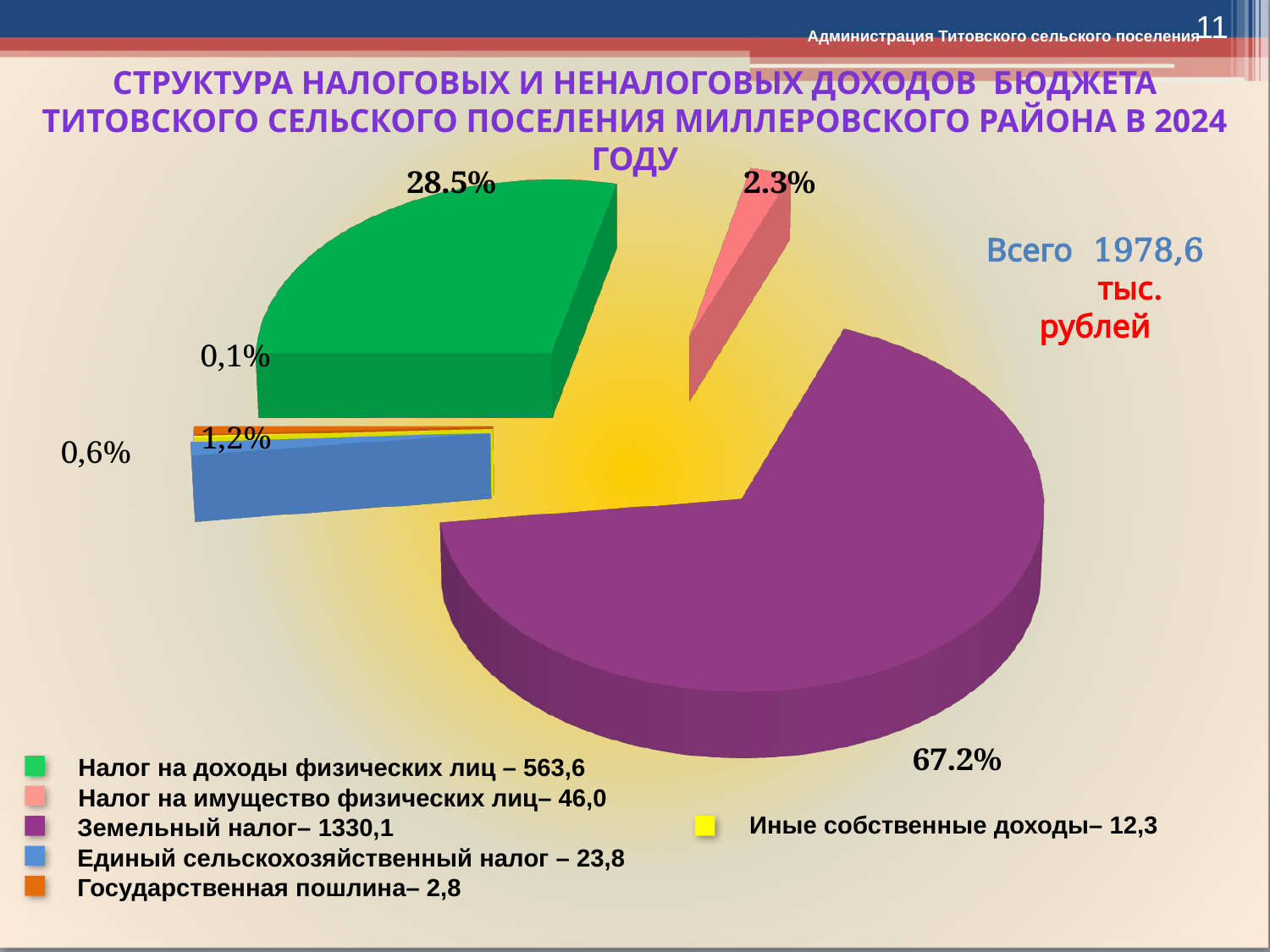
How many categories does the legend list? 6 What share of the pie does Налог на доходы физических лиц hold? 28.5% Which is larger: the slice for Налог на доходы физических лиц or the slice for Налог на имущество физических лиц? Налог на доходы физических лиц What share of the pie does Земельный налог hold? 67.2% Which category has the largest slice of the pie? Земельный налог What share of the pie does Налог на имущество физических лиц hold? 2.3% What is the value shown in the legend for Иные собственные доходы? 12,3 What kind of chart is shown on the slide? pie chart What is the value shown in the legend for Земельный налог? 1330,1 Which category has the smallest slice of the pie? Государственная пошлина What total (Всего) is stated on the slide, in тыс. рублей? 1978,6